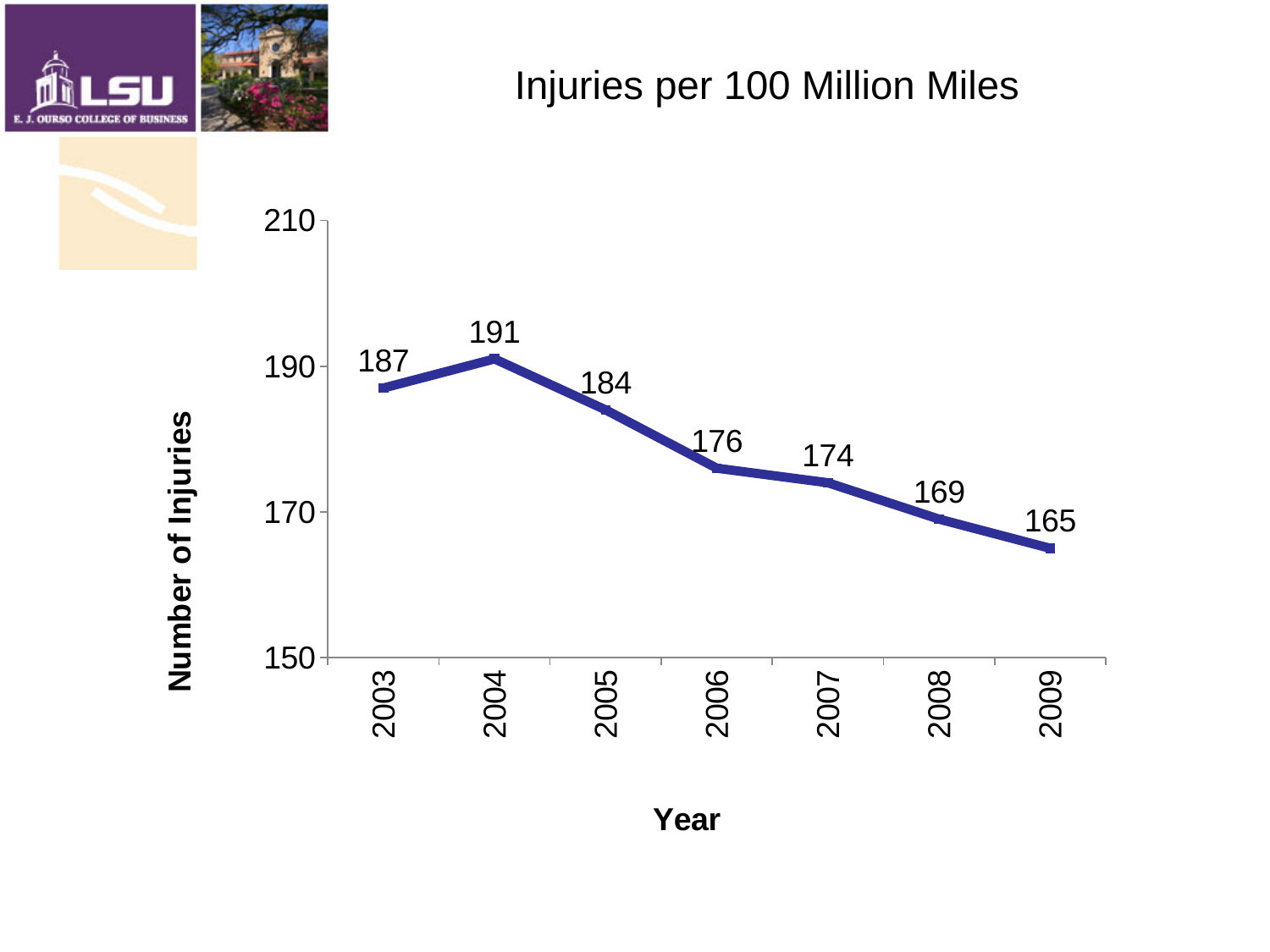
What is the overall trend in injuries from 2004 to 2009? falling Which year has a higher value, 2003 or 2007? 2003 What is the difference between the values for 2003 and 2005? 3 What is the value for 2006? 176 What is the difference between the values for 2004 and 2009? 26 What kind of chart is shown on the slide? line chart How many years are plotted on the chart? 7 Which year has the lowest number of injuries? 2009 What is the number of injuries per 100 million miles in 2004? 191 What is the number of injuries per 100 million miles in 2009? 165 Is the value for 2008 greater or less than 170? less Which year has the highest number of injuries? 2004